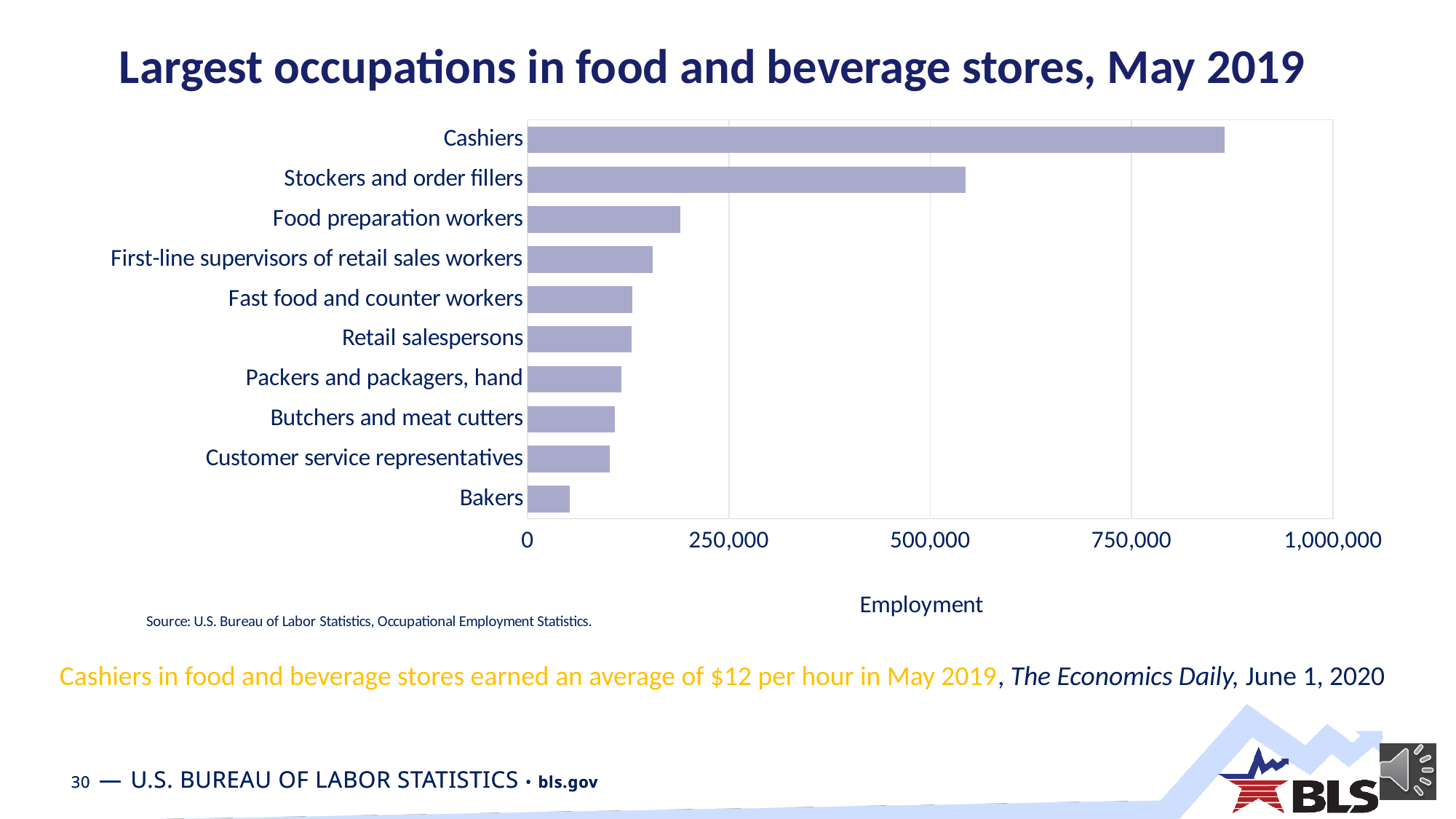
What is the label on the horizontal axis of the chart? Employment Which occupation has the highest employment in the chart? Cashiers Which has higher employment, Cashiers or Stockers and order fillers? Cashiers Is the employment value for Bakers greater or less than 250,000? less What kind of chart is shown on the slide? bar chart What is the title of the chart? Largest occupations in food and beverage stores, May 2019 How many occupations are shown in the chart? 10 Which has higher employment, Food preparation workers or Bakers? Food preparation workers Is the employment value for Food preparation workers greater or less than 250,000? less Is the employment value for Stockers and order fillers greater or less than 500,000? greater Which occupation has the lowest employment in the chart? Bakers